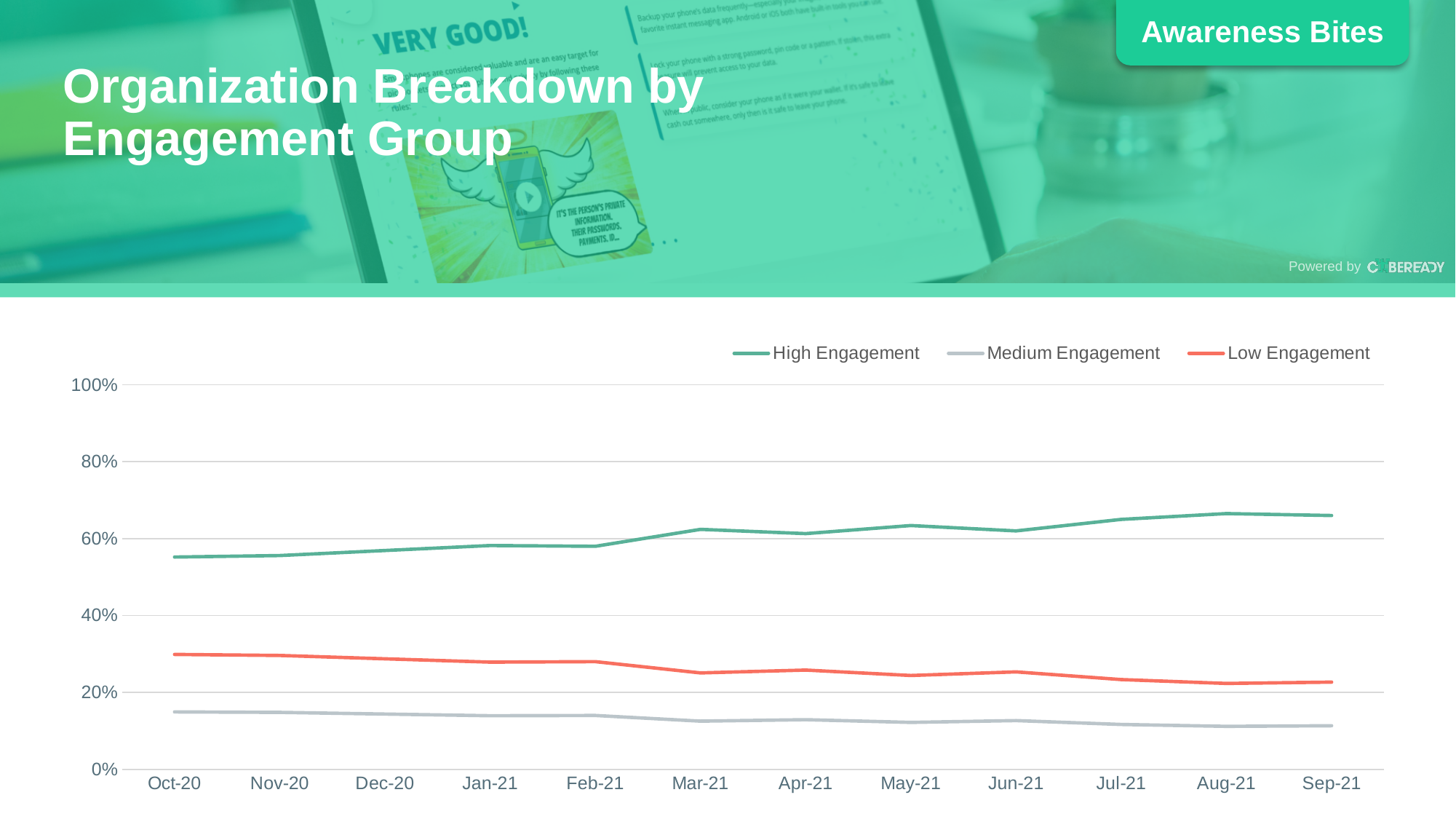
Is the value for High Engagement in Oct-20 greater or less than 60%? less What kind of chart is shown on the slide? Line chart Which engagement group has the highest values across the chart? High Engagement How many series does the legend list? 3 Does the High Engagement line rise or fall from Oct-20 to Sep-21? Rise Is the value for High Engagement in Sep-21 greater or less than 60%? greater Which engagement group has the lowest values across the chart? Medium Engagement Does the Low Engagement line rise or fall from Oct-20 to Sep-21? Fall Which is larger in Sep-21, High Engagement or Low Engagement? High Engagement How many months are shown along the x axis? 12 Is the value for Medium Engagement in Oct-20 greater or less than 20%? less What colour is the Low Engagement line in the legend? Red